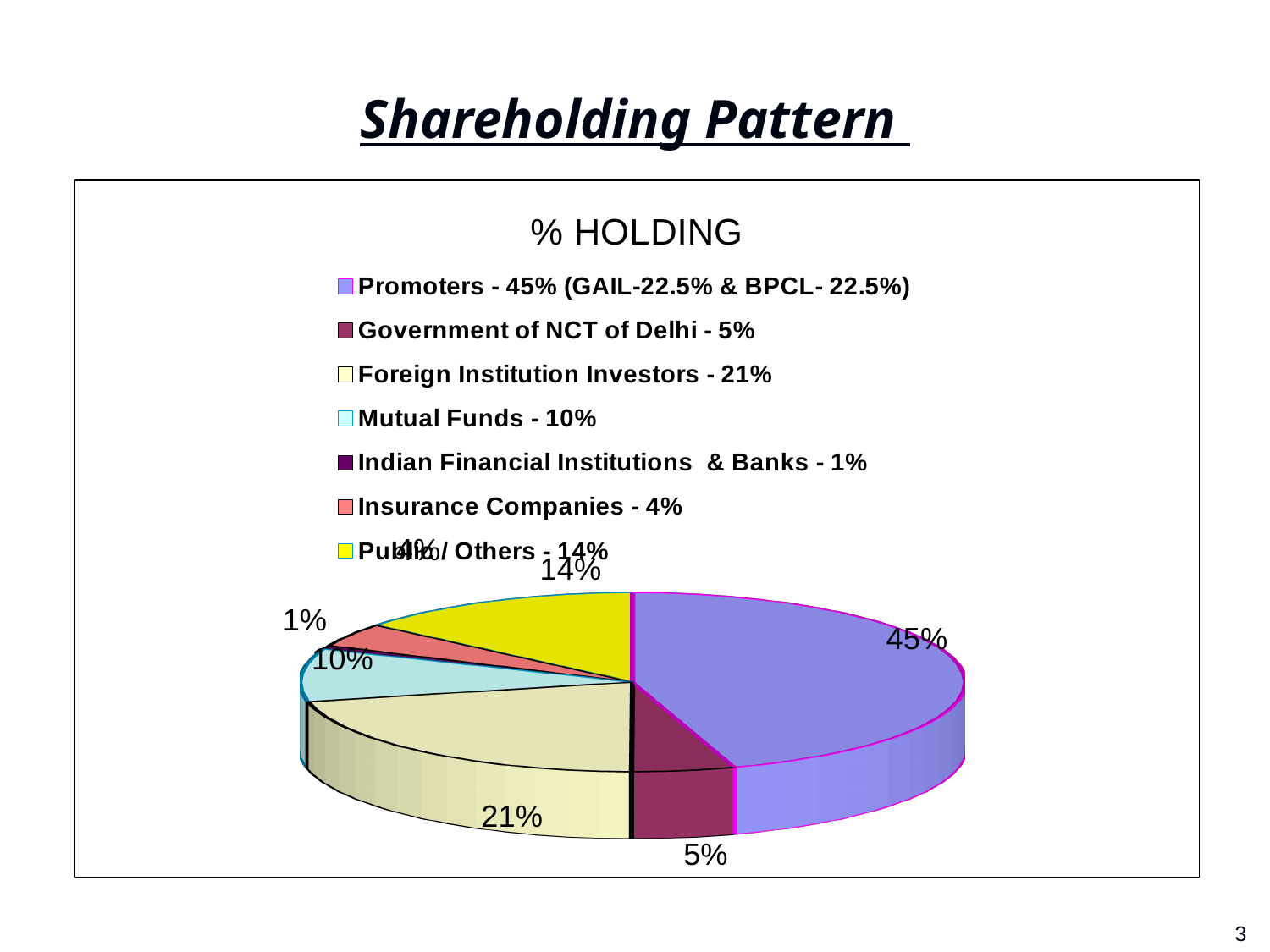
Which category has the largest share of the pie? Promoters What is the difference between the Promoters share and the Foreign Institution Investors share? 24% What is the holding percentage for Mutual Funds? 10% What is the title of the chart? % HOLDING How many categories does the legend list? 7 What share of holding do Foreign Institution Investors have? 21% What is the combined share of GAIL and BPCL as stated in the legend? 45% Which is larger, the share for Public / Others or the share for Mutual Funds? Public / Others What percentage of holding is held by Promoters? 45% What is the holding percentage for Government of NCT of Delhi? 5% Which category has the smallest share of the pie? Indian Financial Institutions & Banks What kind of chart is shown on the slide? pie chart